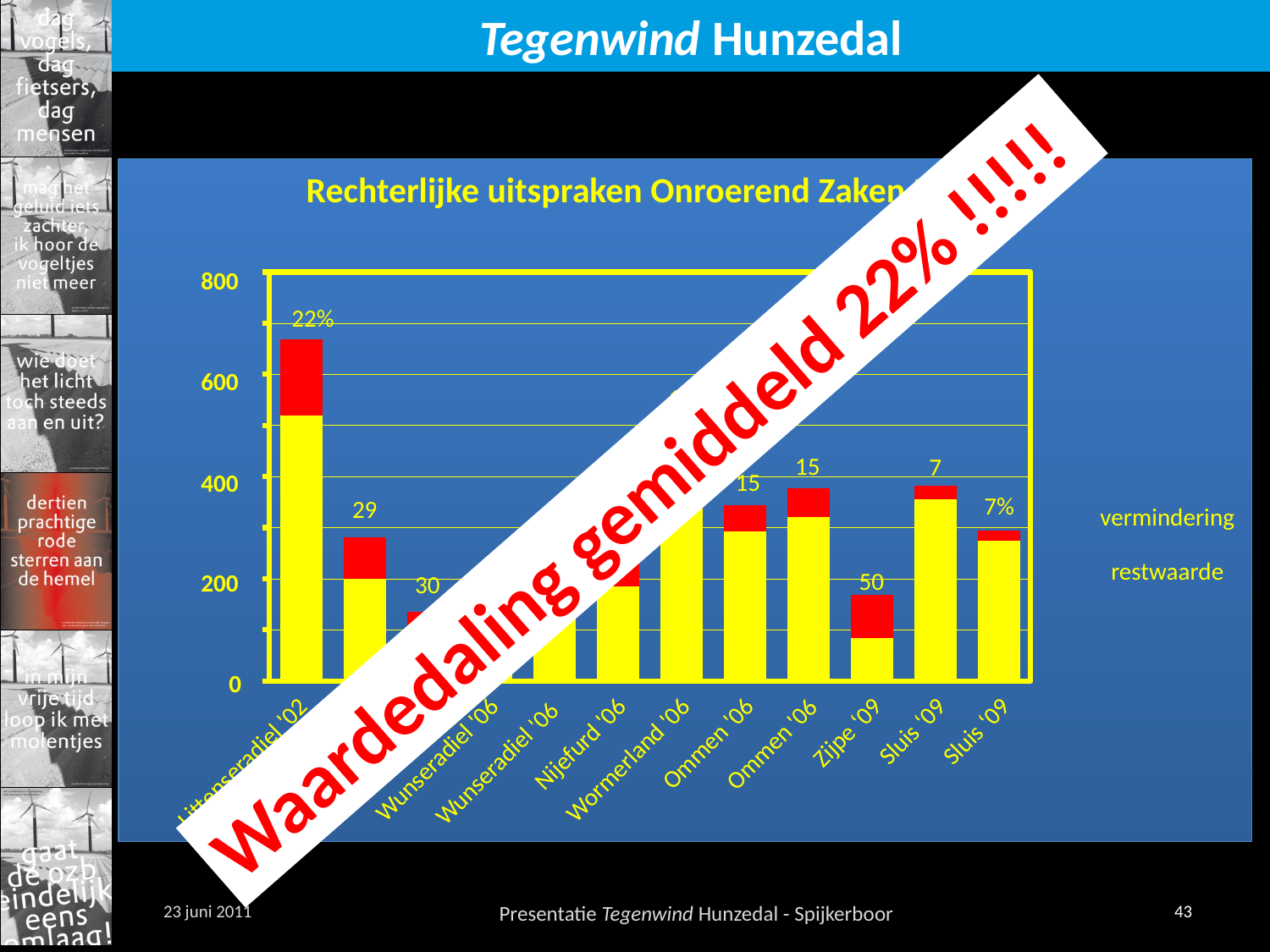
Is the total height of the bar for Zijpe '09 greater or less than 200? less How many series does the chart's legend list? 2 Which bar is taller: Zijpe '09 or the first Sluis '09 bar? Sluis '09 What data label is printed on the tallest bar in the chart? 22% What is the highest value shown on the vertical axis? 800 What kind of chart is shown on the slide? bar chart Is the total height of the first Sluis '09 bar greater or less than 400? less What data label is printed on the bars for Ommen '06? 15 What data label is printed on the bar for Zijpe '09? 50 What does the red diagonal banner across the chart say? Waardedaling gemiddeld 22% !!!!! What are the two legend entries of the chart? vermindering, restwaarde What data label is printed on the last bar, Sluis '09 (rightmost)? 7%